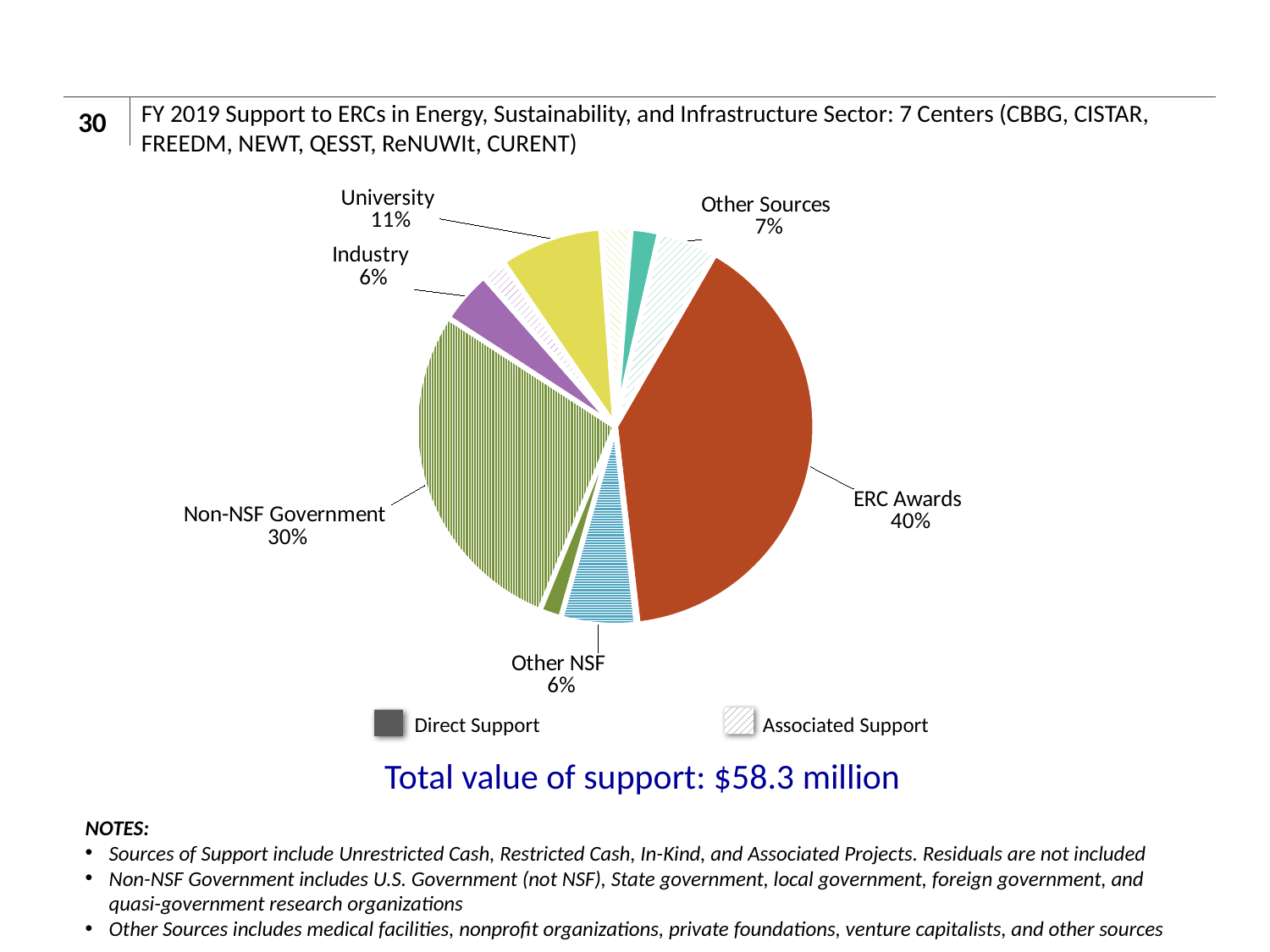
Which labeled category has the largest share of the pie? ERC Awards How many percentage points larger is the ERC Awards share than the Non-NSF Government share? 10 percentage points How many entries does the legend list? 2 What total value of support is stated below the chart? $58.3 million What kind of chart is shown on the slide? Pie chart What percentage of support comes from ERC Awards? 40% What percentage is shown for Other NSF? 6% Which is larger, the share for Other Sources or the share for Industry? Other Sources What percentage is shown for Other Sources? 7% What share of the pie is labeled Non-NSF Government? 30% What percentage is shown for University? 11% Which is larger, the share for Non-NSF Government or the share for University? Non-NSF Government